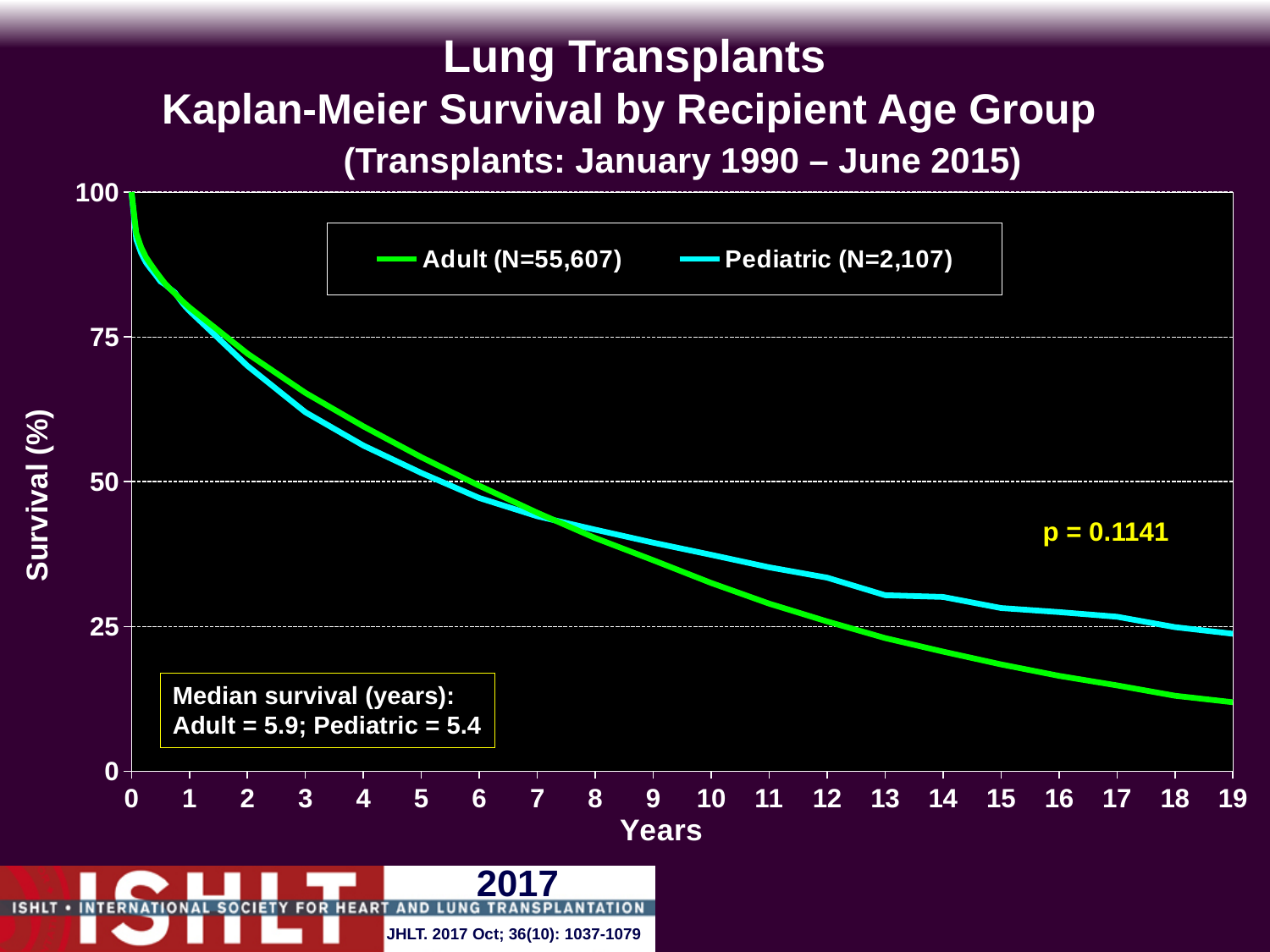
What kind of chart is shown on the slide? line chart What is the median survival in years for the Adult group? 5.9 Which colour is used for the Pediatric series? light blue What is the median survival in years for the Pediatric group? 5.4 How many series does the legend list? 2 Is the Pediatric survival at 10 years greater or less than 25? greater What p-value is shown on the chart? p = 0.1141 Is the Adult survival at 19 years greater or less than 25? less Do the survival curves rise or fall as years increase? fall What is the N for the Pediatric group in the legend? 2,107 What is the N for the Adult group in the legend? 55,607 At 15 years, which group has the higher survival, Adult or Pediatric? Pediatric